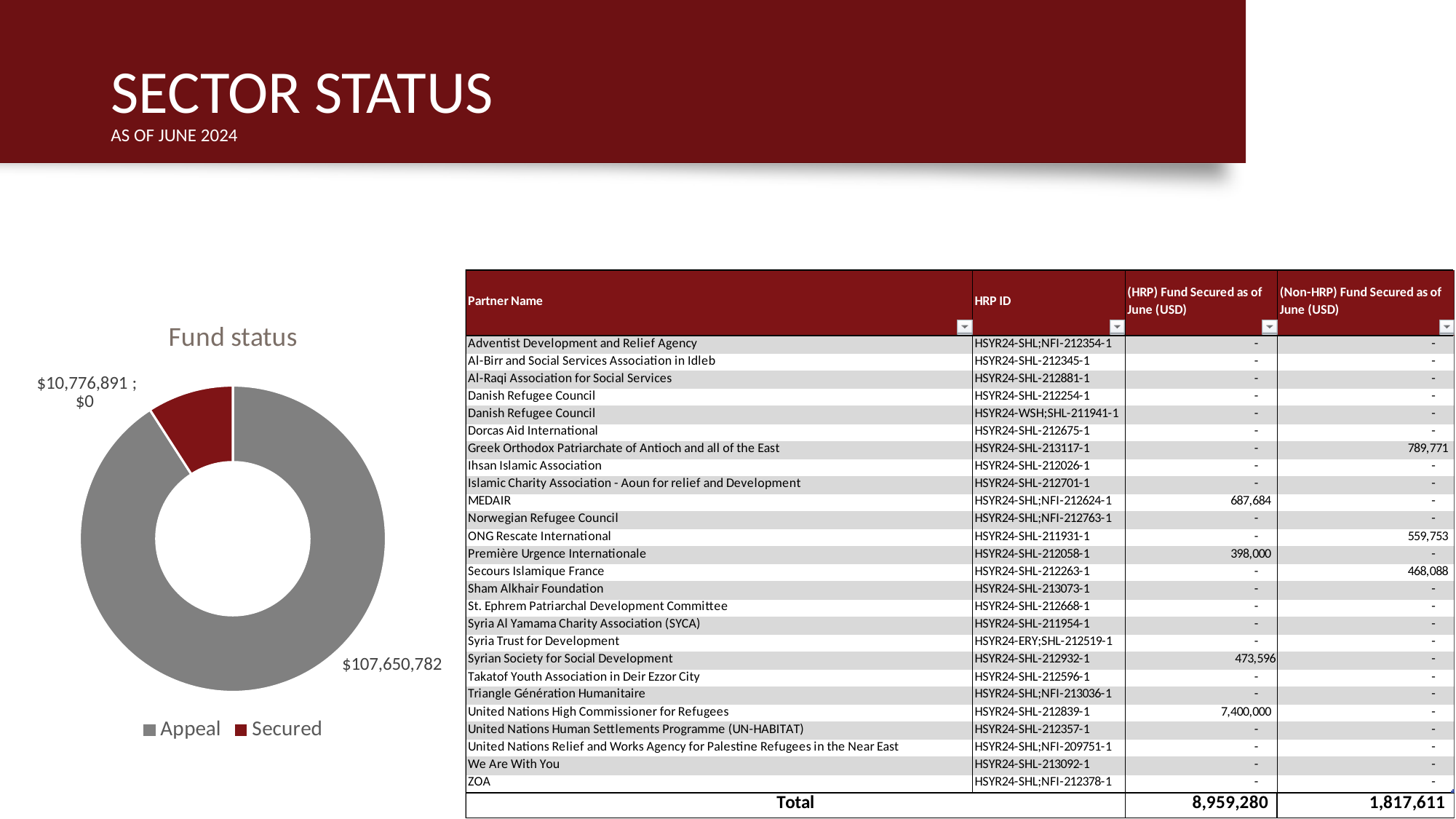
In the Fund status chart, which is larger, Appeal or Secured? Appeal What are the two legend entries of the Fund status chart? Appeal and Secured Which slice of the Fund status chart is the largest? Appeal How many slices does the Fund status chart have? 2 What is the title of the chart on the left of the slide? Fund status How many entries does the legend of the Fund status chart list? 2 What kind of chart is shown under the title "Fund status"? doughnut (pie) chart In the Fund status chart, what value is shown for Appeal? $107,650,782 Which slice of the Fund status chart is the smallest? Secured In the Fund status chart, what data label is printed next to the Secured slice? $10,776,891 ; $0